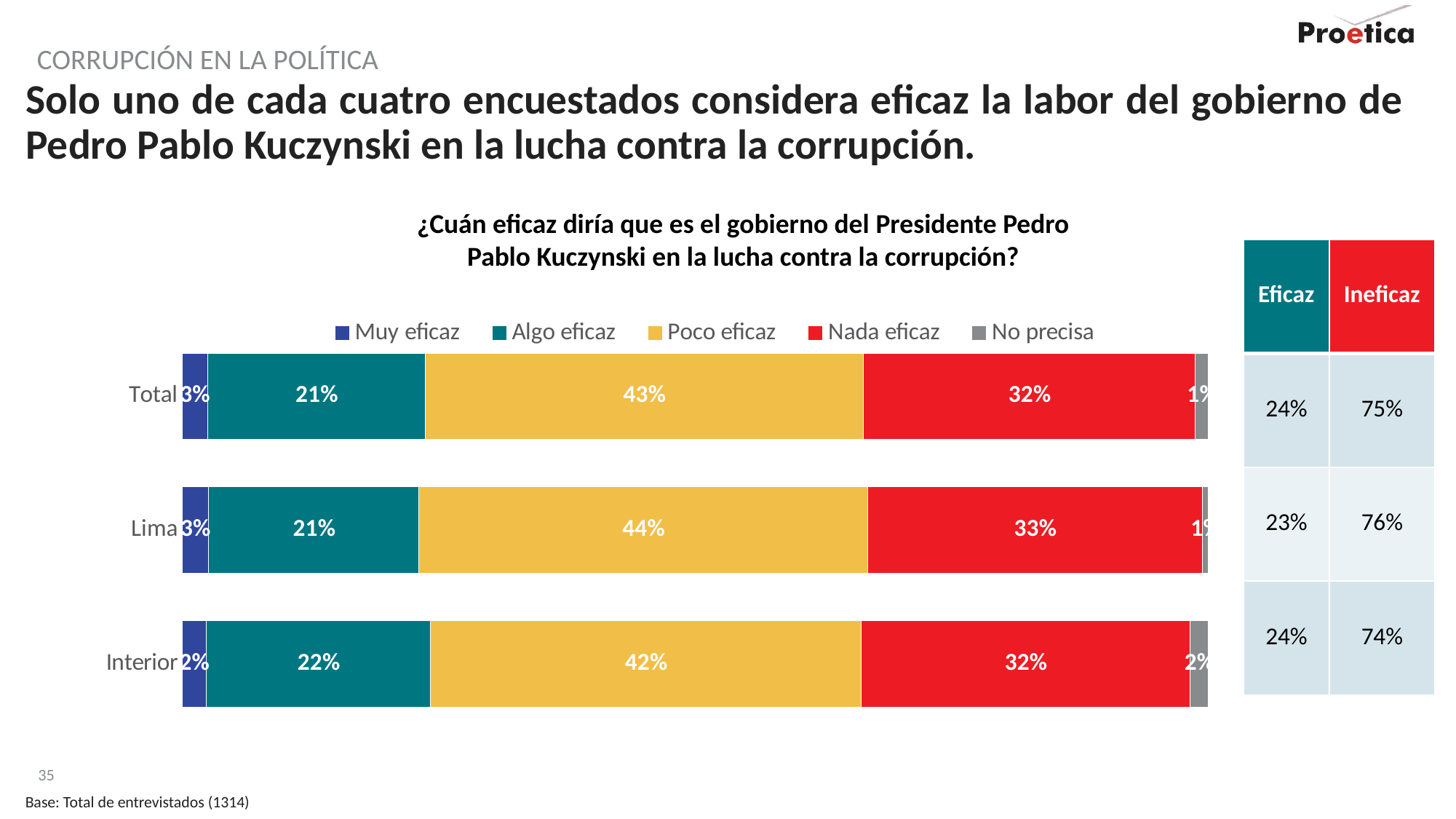
Which series in the legend is shown in red? Nada eficaz How many categories (bars) are shown in the chart? 3 What is the value for "Nada eficaz" in the Lima bar? 33% What type of chart is shown on the slide? Stacked bar chart What is the difference between the "Poco eficaz" value for Lima and the "Nada eficaz" value for Lima? 11% What is the value for "Poco eficaz" in the Total bar? 43% What is the value for "Algo eficaz" in the Interior bar? 22% Which category has the highest value for "Poco eficaz"? Lima How many series does the chart legend list? 5 Which category has the lowest value for "Poco eficaz"? Interior What is the value for "Muy eficaz" in the Interior bar? 2% Is the "Nada eficaz" value for Total larger or smaller than the "Algo eficaz" value for Total? Larger